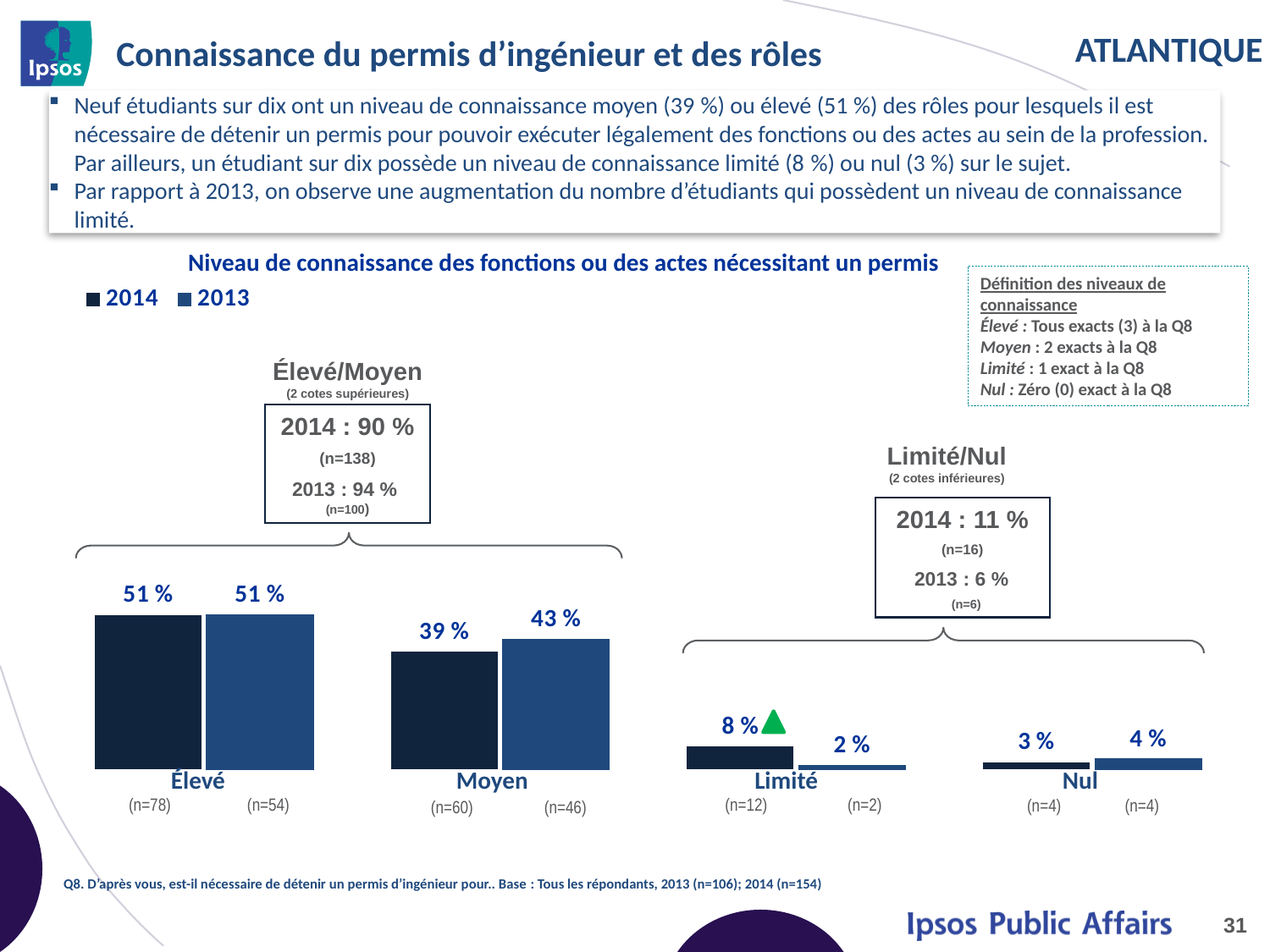
What is the value for Élevé in the 2013 series? 51 % What is the value for Moyen in the 2014 series? 39 % Which category has the lowest value in the 2013 series? Limité What is the value for Limité in the 2013 series? 2 % How many series does the legend list? 2 How many categories are shown on the x axis of the chart? 4 What kind of chart is shown on the slide? Bar chart What is the difference between the 2013 and 2014 values for Moyen? 4 % What is the difference between the 2014 and 2013 values for Limité? 6 % What is the value for Nul in the 2014 series? 3 % Which category has the highest value in the 2014 series? Élevé Which is larger for Limité: the 2014 value or the 2013 value? 2014